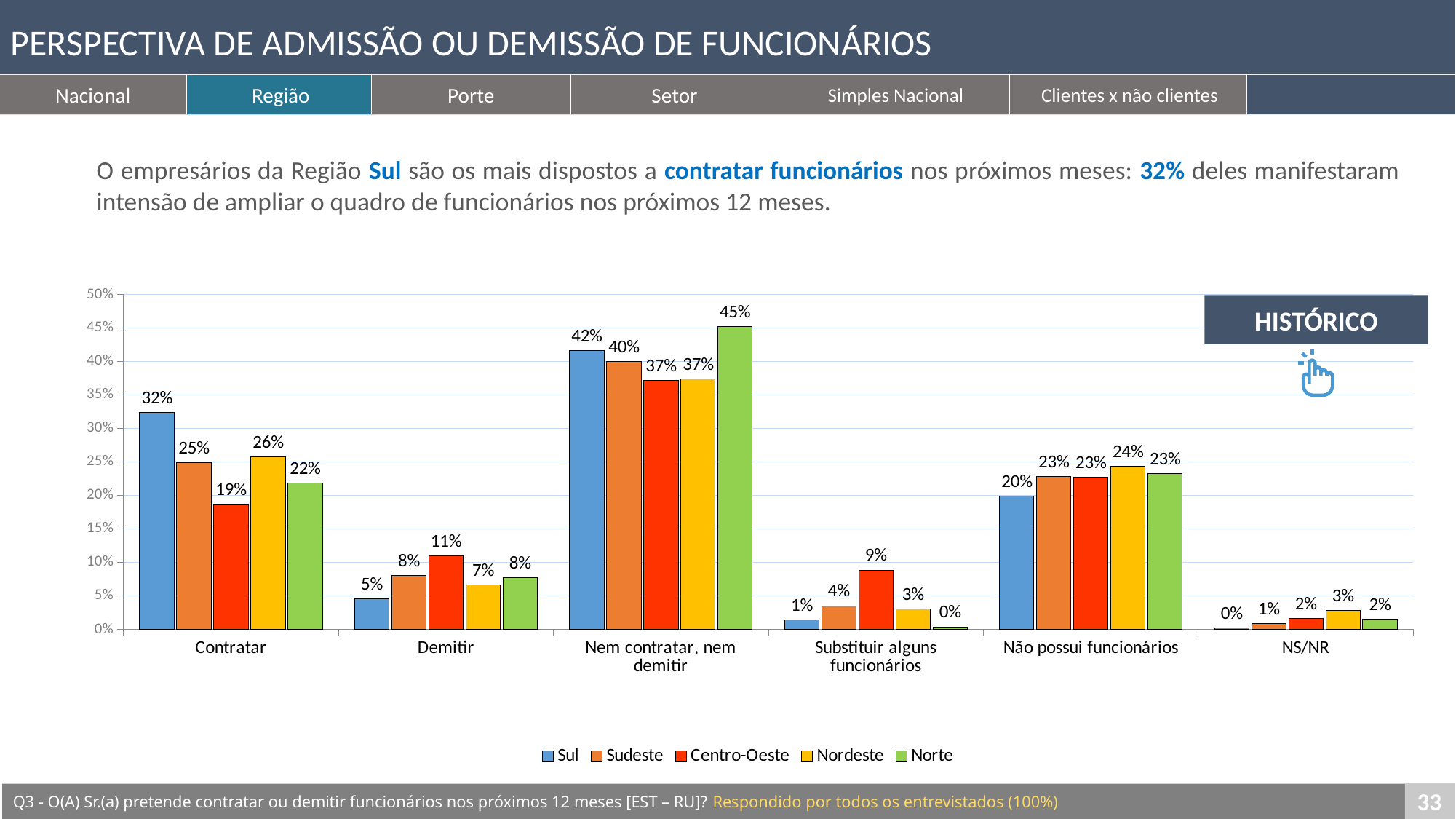
What is the difference between Norte and Sul in the Nem contratar, nem demitir category? 3% Which region has the highest value in the Demitir category? Centro-Oeste What is the value for Norte in the Nem contratar, nem demitir category? 45% What is the value for Centro-Oeste in the Substituir alguns funcionários category? 9% Is the value for Sudeste in the Contratar category greater or less than 30%? less Which colour represents Nordeste in the legend? yellow How many series does the legend list? 5 Which is larger in the Não possui funcionários category: Sul or Nordeste? Nordeste What is the value for Sul in the Contratar category? 32% What kind of chart is shown on the slide? bar chart Which region has the lowest value in the Contratar category? Centro-Oeste How many categories are shown on the x axis? 6